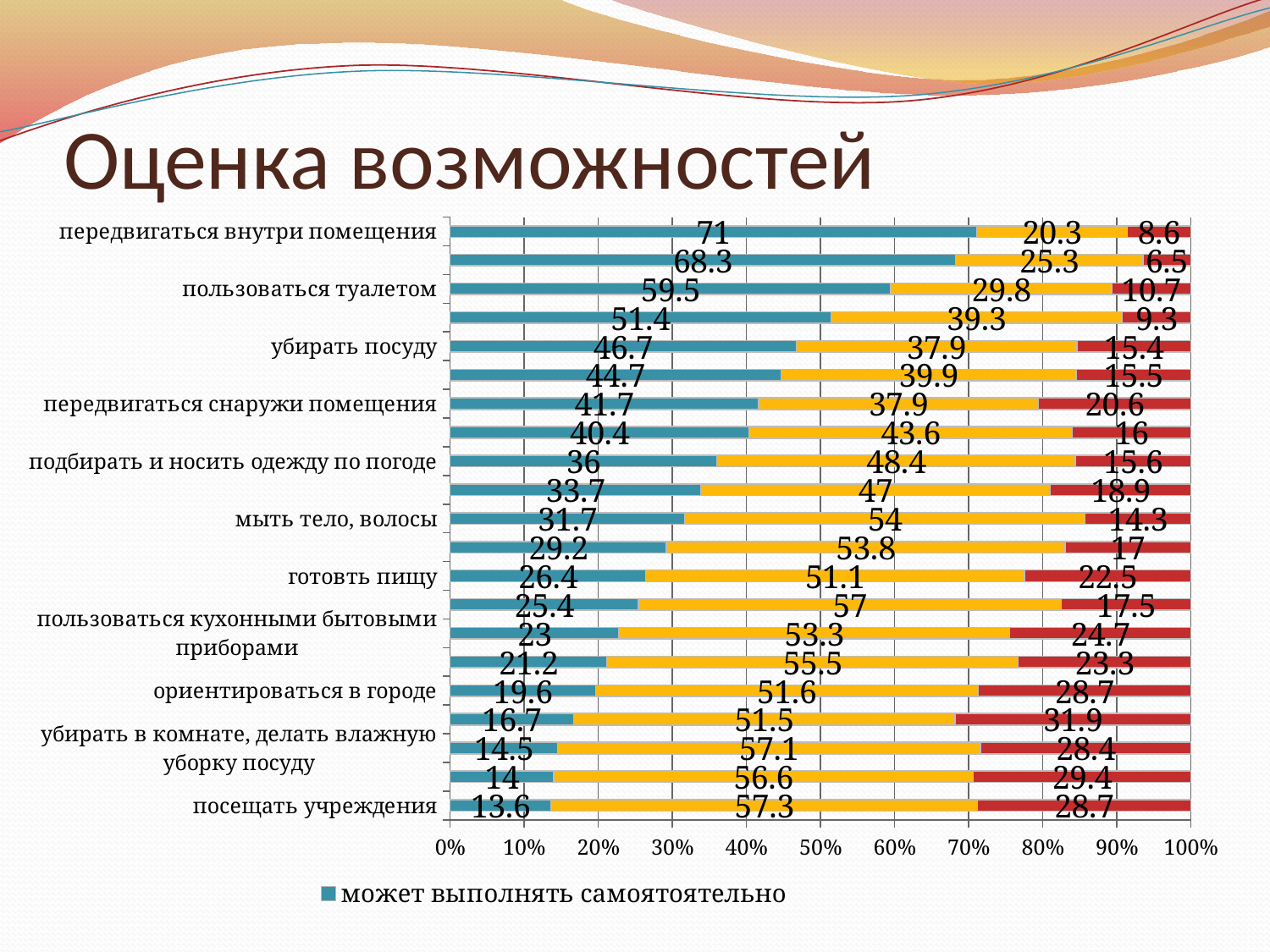
Do the values of the blue series (может выполнять самостоятельно) increase or decrease going from the top bar to the bottom bar? decrease What is the value of the red segment for "передвигаться снаружи помещения"? 20.6 What is the text of the legend entry shown below the chart? может выполнять самоятоятельно Which has a larger "может выполнять самостоятельно" value: "пользоваться туалетом" or "убирать посуду"? пользоваться туалетом Which labeled category has the highest value for "может выполнять самостоятельно"? передвигаться внутри помещения What is the value of the red segment for "посещать учреждения"? 28.7 What kind of chart is shown on the slide? Stacked bar chart What is the value of the blue series (может выполнять самостоятельно) for "передвигаться внутри помещения"? 71 Which labeled category has the lowest value for "может выполнять самостоятельно"? посещать учреждения How many bars are plotted in the chart? 21 What is the value of the yellow segment for "мыть тело, волосы"? 54 What is the difference between the "может выполнять самостоятельно" values for "передвигаться внутри помещения" and "посещать учреждения"? 57.4